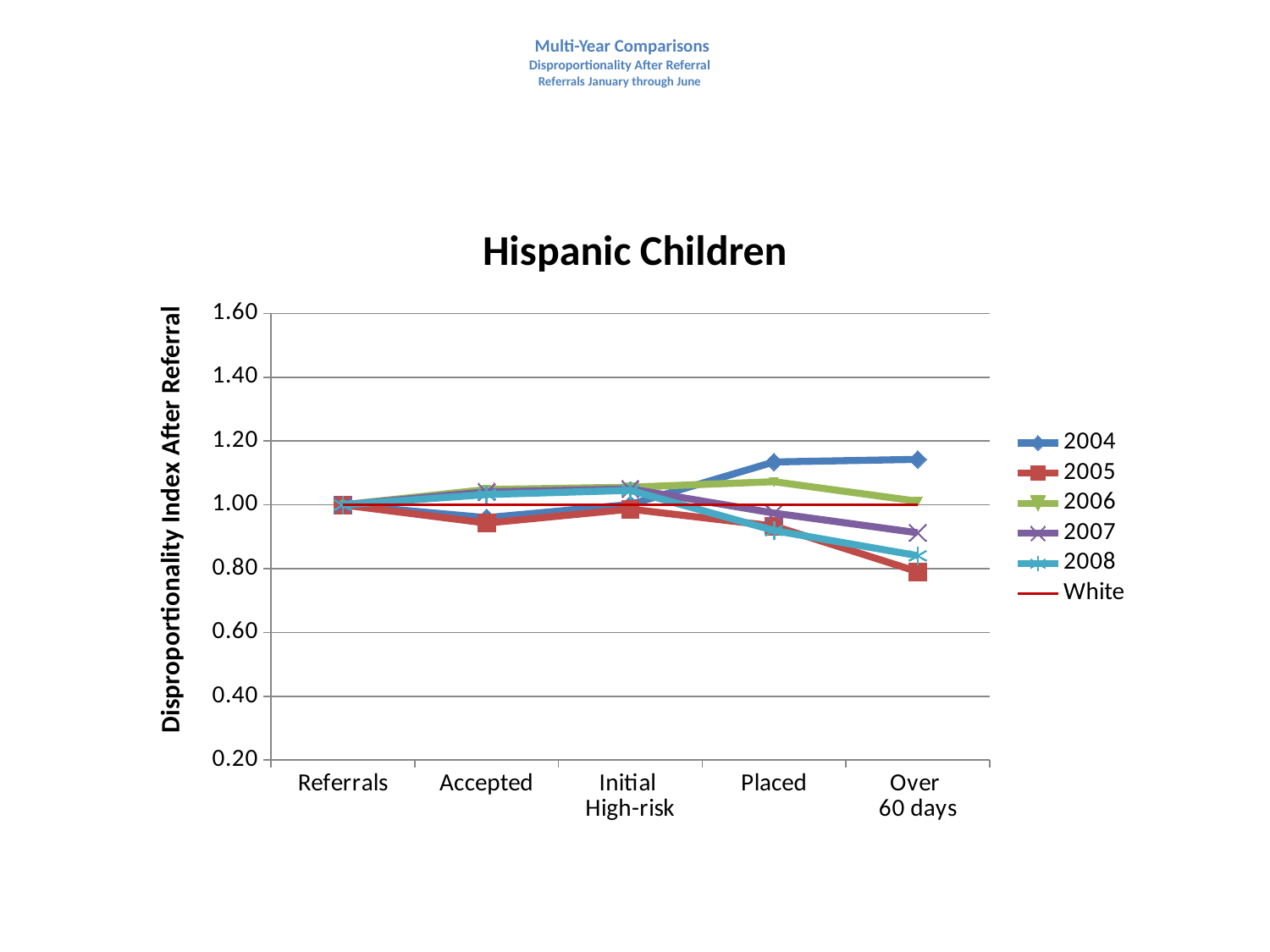
Does the 2005 series rise or fall from Initial High-risk to Over 60 days? fall How many categories are shown on the x axis? 5 Is the value for 2004 at Over 60 days greater or less than 1.00? greater Which series has the lowest value at Over 60 days? 2005 Which series has the highest value at Over 60 days? 2004 What is the value of the White series across all categories? 1.00 How many series does the legend list? 6 Which is larger at Placed, the value for 2004 or the value for 2005? 2004 What is the label of the vertical axis? Disproportionality Index After Referral What kind of chart is shown on the slide? line chart Is the value for 2008 at Over 60 days greater or less than 1.00? less What is the title of the chart? Hispanic Children